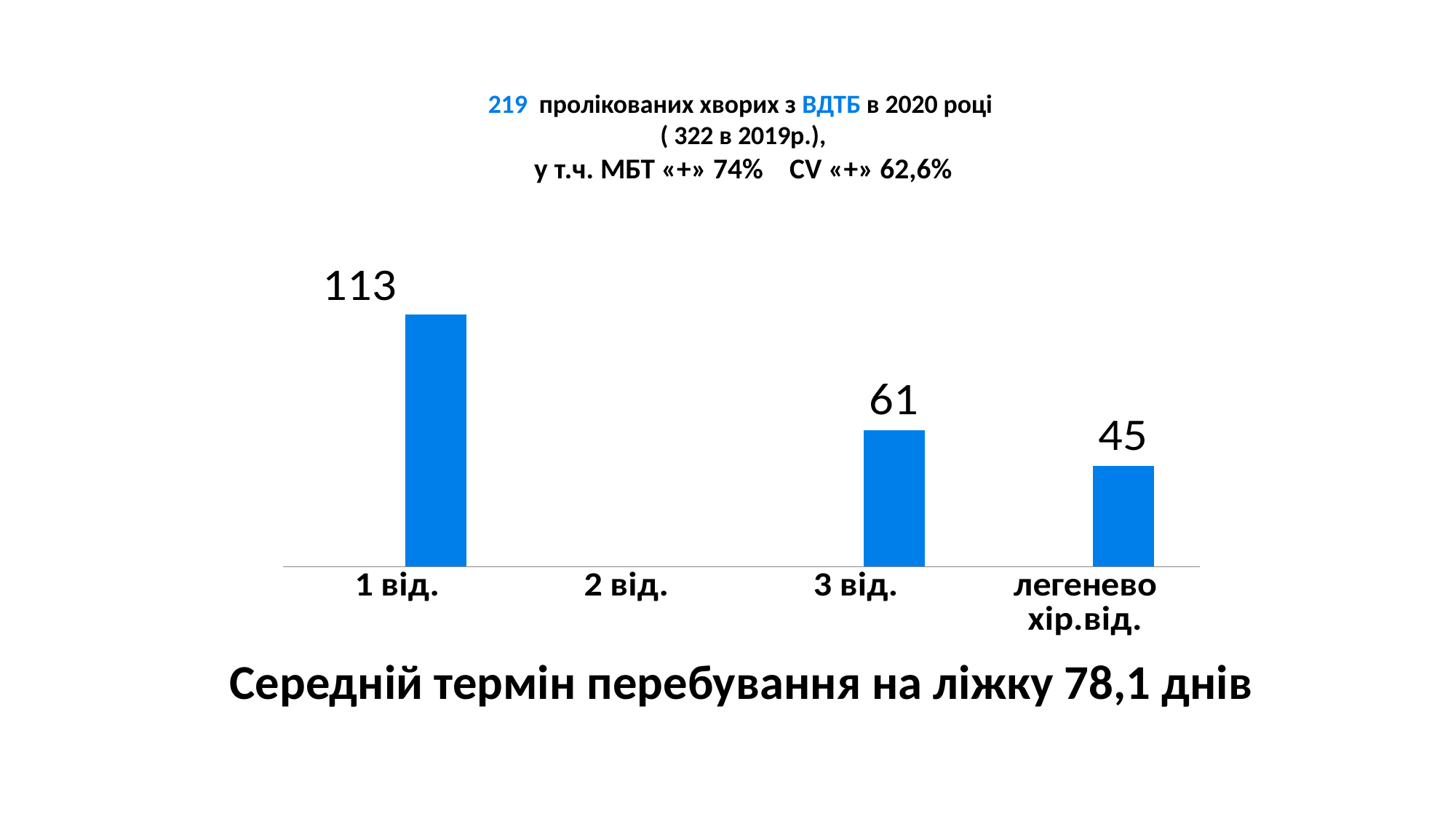
Which is larger, the value for 3 від. or the value for легенево хір.від.? 3 від. How many bars are plotted on the chart? 3 What is the value for 3 від.? 61 What is the difference between the values for 3 від. and легенево хір.від.? 16 What is the difference between the values for 1 від. and 3 від.? 52 What is the value for легенево хір.від.? 45 Which category with a plotted bar has the lowest value? легенево хір.від. Which category has the highest value? 1 від. How many categories are labelled on the x axis? 4 What kind of chart is shown on the slide? bar chart What is the value for 1 від.? 113 Which category on the x axis has no bar plotted? 2 від.